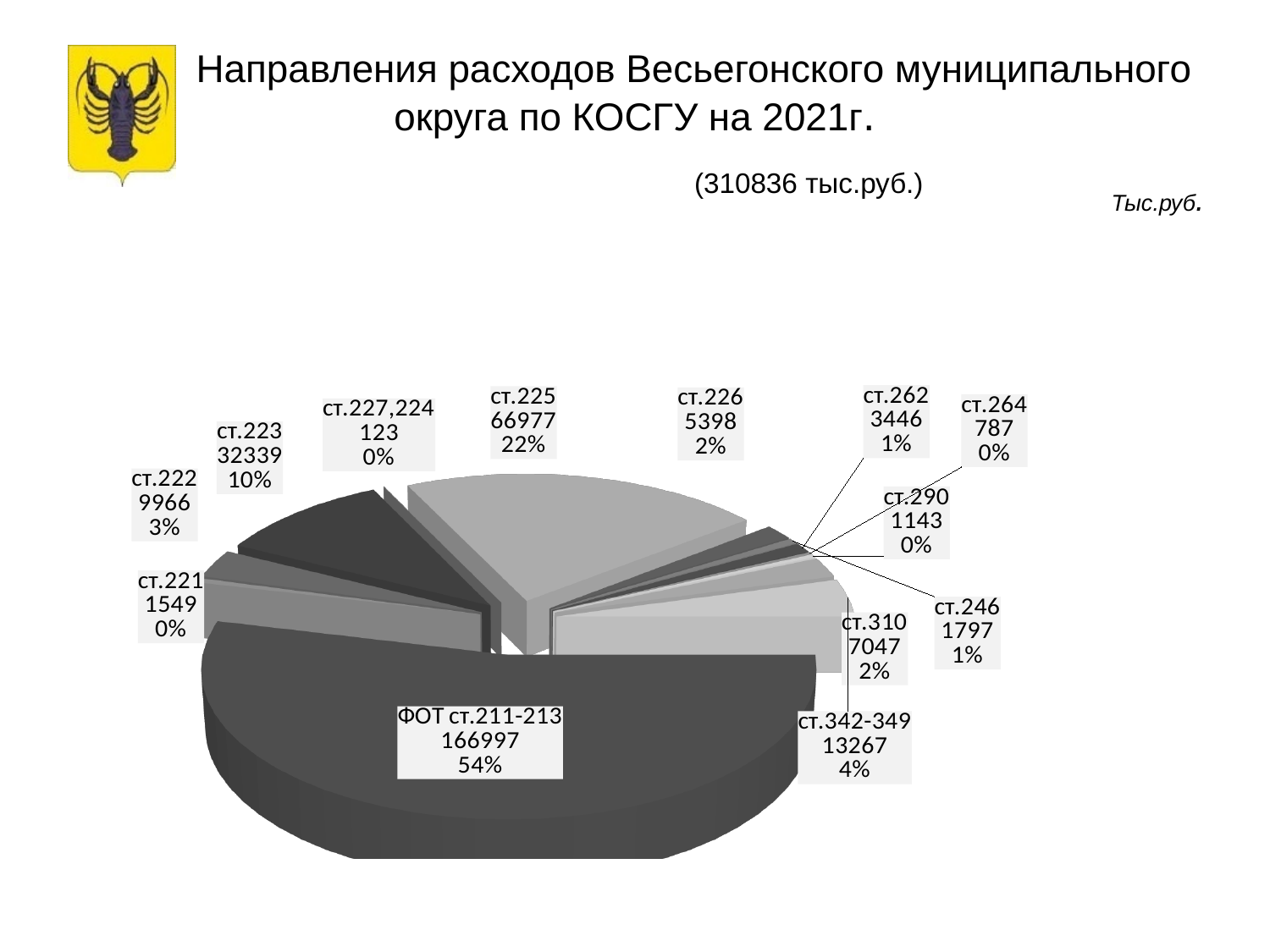
What is the difference between the values for ст.225 and ст.223? 34638 What share of the pie does ст.223 represent? 10% Which category has the largest slice of the pie? ФОТ ст.211-213 What is the value for ФОТ ст.211-213? 166997 What share of the pie does ст.225 represent? 22% Which is larger, the value for ст.310 or the value for ст.226? ст.310 What kind of chart is shown on the slide? pie chart How many slices does the pie chart have? 13 What is the value for ст.223? 32339 What is the value for ст.225? 66977 What is the value for ст.342-349? 13267 Which category has the smallest value? ст.227,224